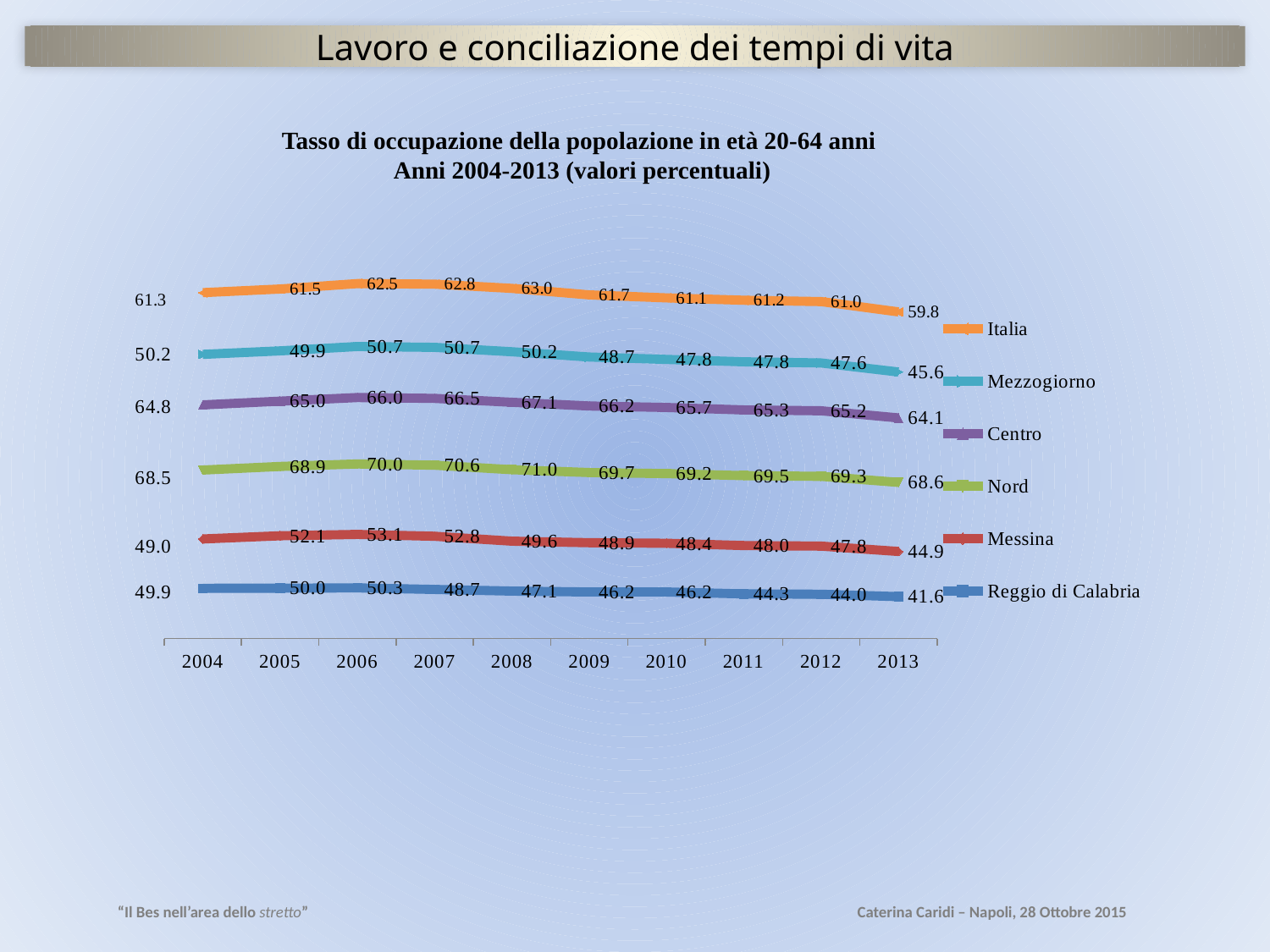
How many years are shown on the x axis? 10 What is the value for Italia in 2013? 59.8 Does the Reggio di Calabria series rise or fall from 2006 to 2013? Fall In which year does the Nord series reach its highest value? 2008 In which year does the Mezzogiorno series have its lowest value? 2013 How many series does the legend list? 6 What is the value for Reggio di Calabria in 2004? 49.9 What kind of chart is shown on the slide? Line chart What is the value for Messina in 2006? 53.1 Which age range is mentioned in the chart title? 20-64 anni Which is larger in 2013, the value for Messina or the value for Reggio di Calabria? Messina What is the difference between the Italia values in 2008 and 2013? 3.2